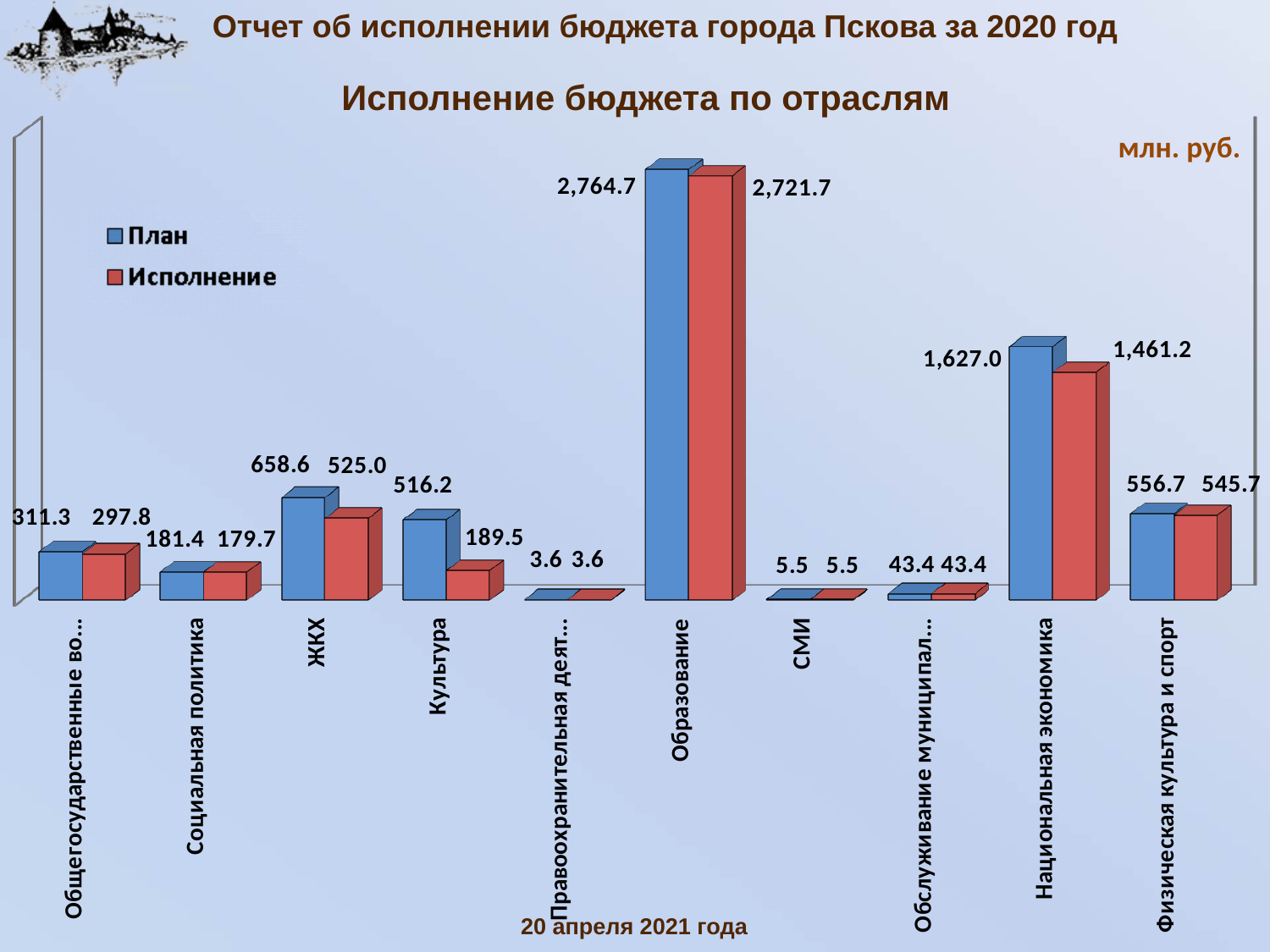
What kind of chart is shown on the slide? Bar chart What is the difference between the План and Исполнение values for Национальная экономика? 165.8 What is the План value for Национальная экономика? 1,627.0 What is the Исполнение value for Физическая культура и спорт? 545.7 How many categories are shown on the x axis? 10 How many series does the legend list? 2 What is the Исполнение value for ЖКХ? 525.0 What is the difference between the План and Исполнение values for Культура? 326.7 Which is larger, the Исполнение value for ЖКХ or the Исполнение value for Физическая культура и спорт? Физическая культура и спорт Which category has the highest План value? Образование What is the Исполнение value for Культура? 189.5 What is the План value for Образование? 2,764.7